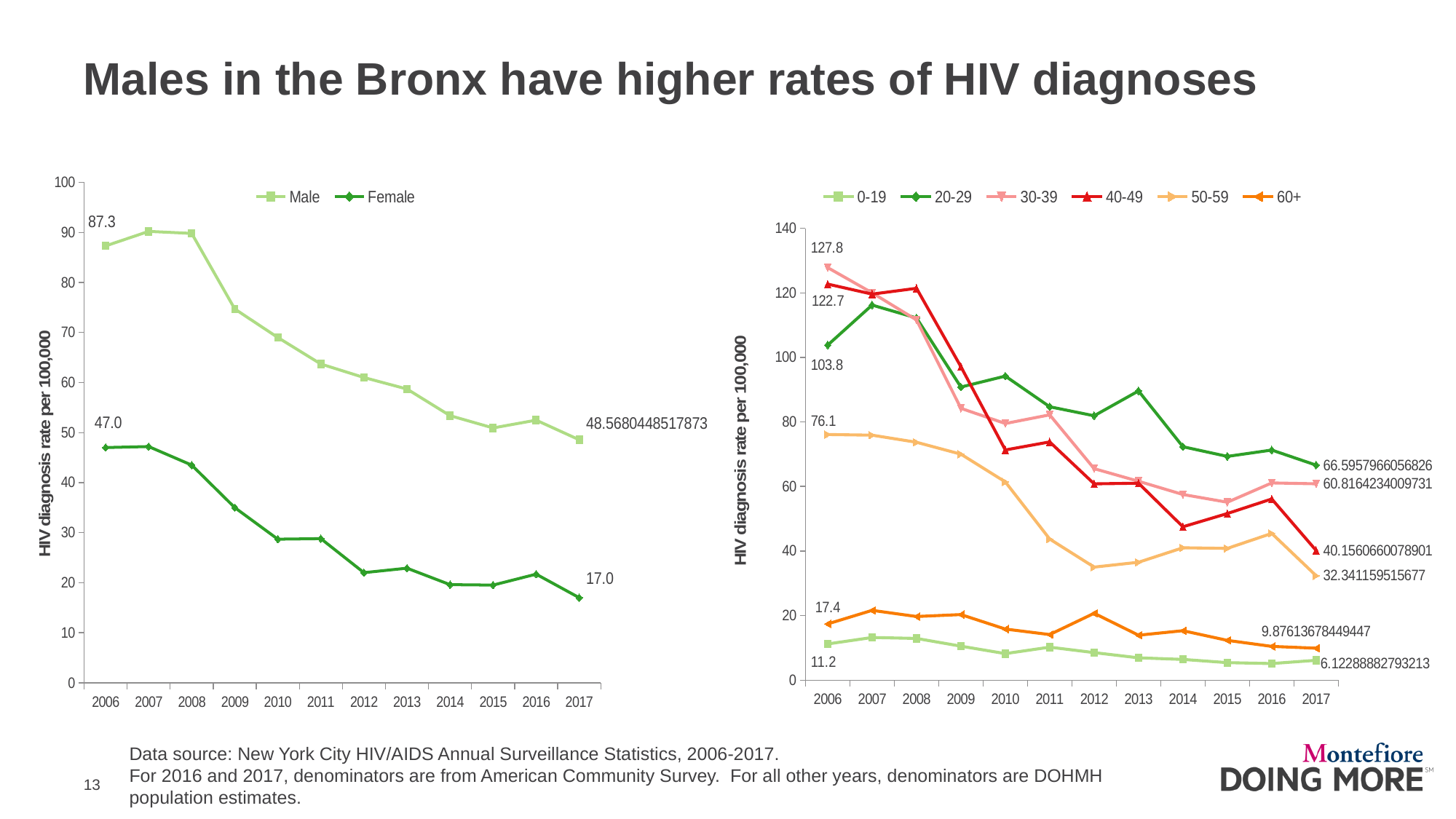
In the right chart, what is the rate for the 30-39 age group in 2006? 127.8 In the right chart, which age group has the lowest rate in 2017? 0-19 In the left chart, is the Male value for 2010 greater or less than 60? greater How many series does the legend of the right chart list? 6 In the right chart, which age group has the highest rate in 2006? 30-39 In the left chart, what is the HIV diagnosis rate for Males in 2006? 87.3 How many years are shown on the x axis of the right chart? 12 In the left chart, what is the difference between the Male and Female rates in 2006? 40.3 How many series does the legend of the left chart list? 2 In the left chart, does the Male rate rise or fall from 2006 to 2017? Fall What kind of chart is the left chart? Line chart In the left chart, what is the HIV diagnosis rate for Females in 2017? 17.0